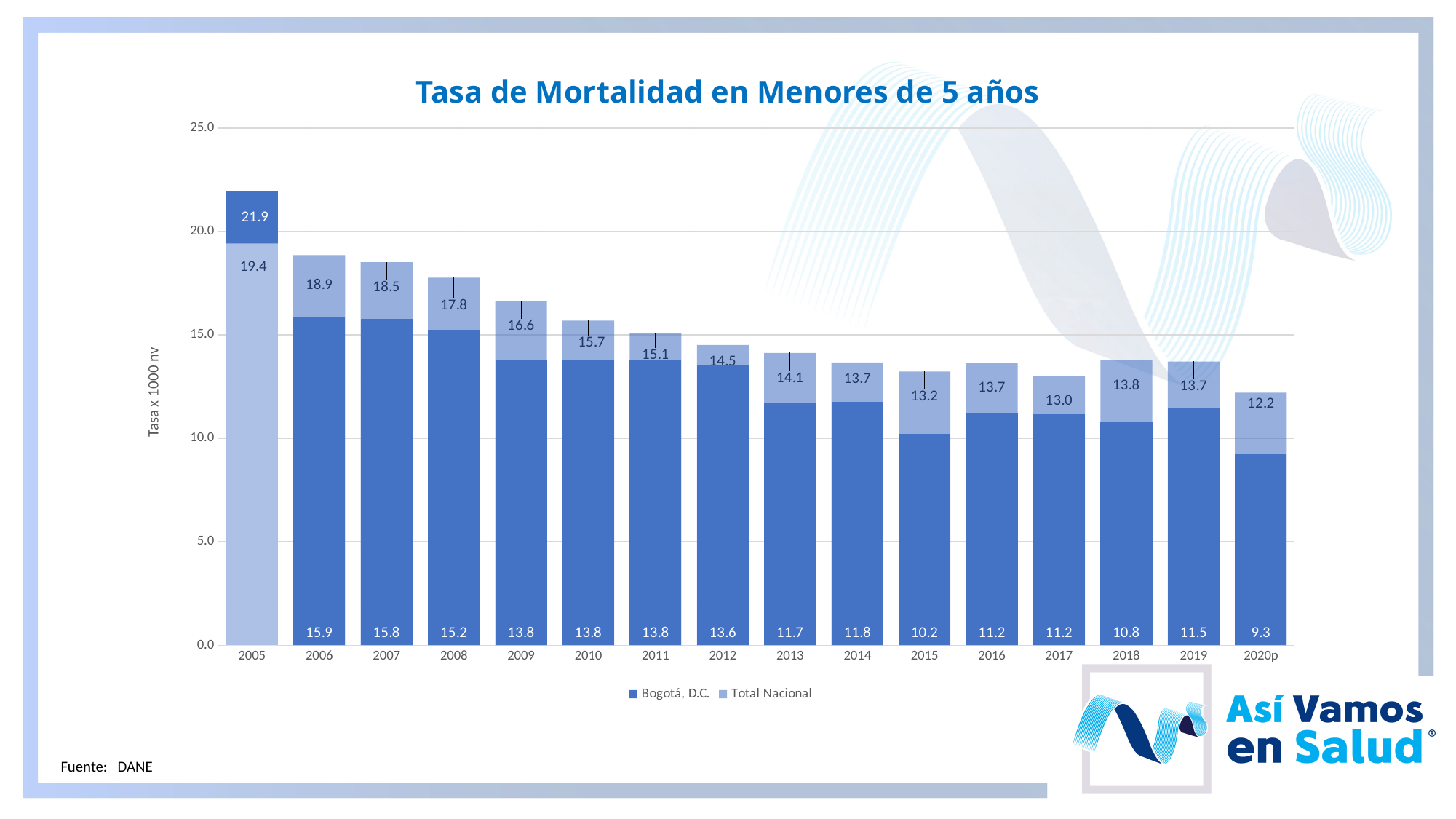
What is the value for Bogotá, D.C. in 2015? 10.2 What is the Total Nacional value in 2005? 19.4 How many series does the legend list? 2 In which year is the Total Nacional value lowest? 2020p In which year is the Bogotá, D.C. value highest? 2005 In 2005, which is larger: the Bogotá, D.C. value or the Total Nacional value? Bogotá, D.C. How many years are shown on the x axis? 16 What kind of chart is shown on the slide? Bar chart Do the Total Nacional values generally rise or fall from 2005 to 2020p? Fall What is the Total Nacional value in 2012? 14.5 What is the difference between the Total Nacional value and the Bogotá, D.C. value in 2019? 2.2 What is the value for Bogotá, D.C. in 2020p? 9.3